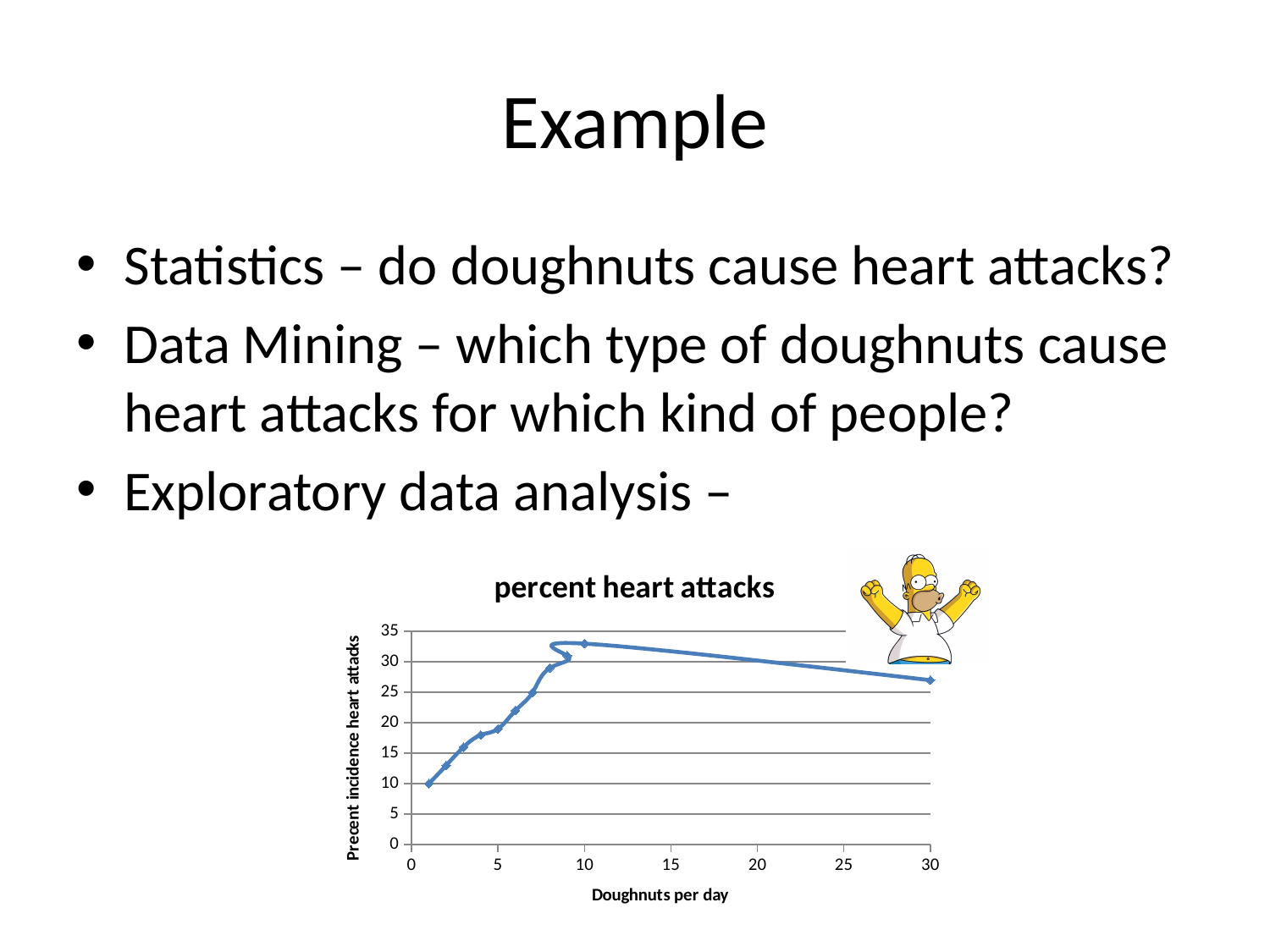
What kind of chart is shown on the slide? line chart At how many doughnuts per day is the percent incidence of heart attacks highest? 10 Between 1 and 10 doughnuts per day, does the percent incidence of heart attacks rise or fall? rise Which has a higher percent incidence of heart attacks: 10 doughnuts per day or 30 doughnuts per day? 10 doughnuts per day What is the label of the x axis of the chart? Doughnuts per day Is the percent incidence of heart attacks at 1 doughnut per day greater or less than 15? less Is the percent incidence of heart attacks at 10 doughnuts per day greater or less than 30? greater Is the percent incidence of heart attacks at 5 doughnuts per day greater or less than 25? less What is the title of the chart? percent heart attacks At how many doughnuts per day is the percent incidence of heart attacks lowest? 1